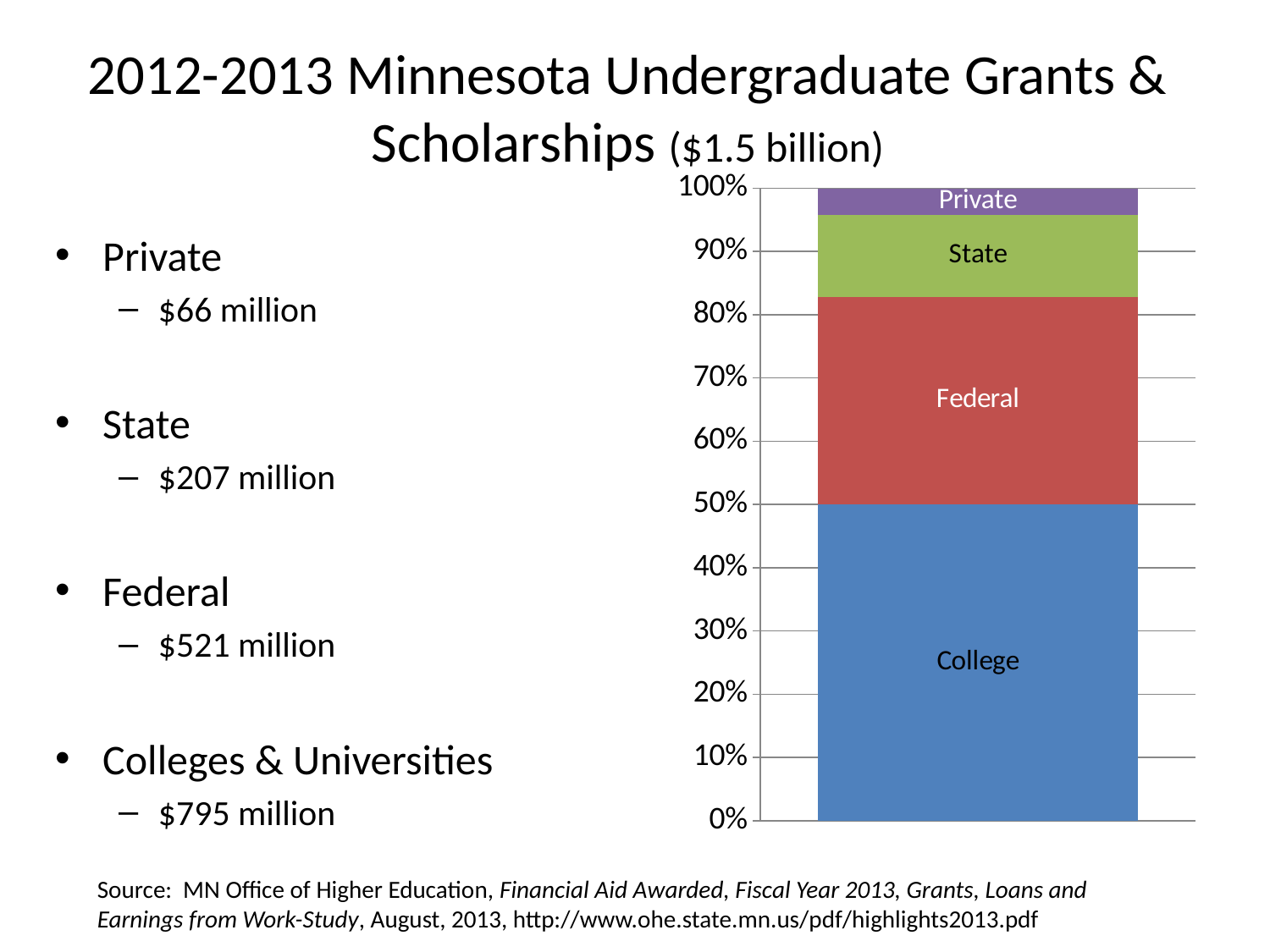
What kind of chart is shown on the slide? stacked bar chart Which segment of the stacked bar is the smallest? Private Is the College segment's share greater or less than 40%? greater According to the slide, how much was awarded by Colleges & Universities? $795 million Which segment of the stacked bar is the largest? College Is the Federal segment's share greater or less than 20%? greater What colour is the College segment of the bar? blue Which segment is larger, State or Federal? Federal Which segment is larger, Private or State? State How many segments make up the stacked bar? 4 Is the Private segment's share greater or less than 10%? less According to the slide, how much was awarded in Federal grants and scholarships? $521 million